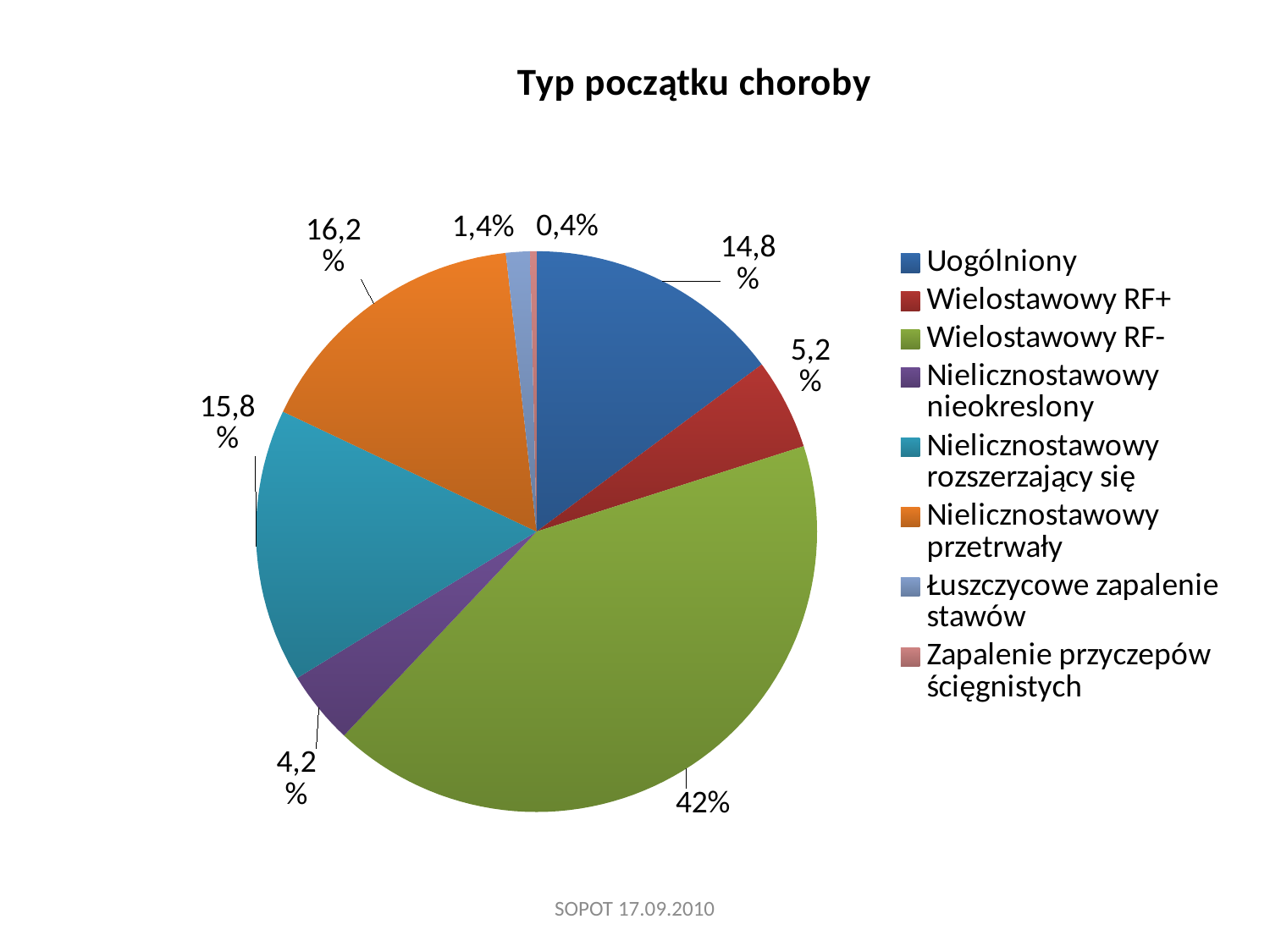
What is the title of the chart? Typ początku choroby How many categories does the legend list? 8 Which is larger, Wielostawowy RF+ or Nielicznostawowy nieokreslony? Wielostawowy RF+ What share of the pie is Wielostawowy RF-? 42% What is the value for Zapalenie przyczepów ścięgnistych? 0,4% What is the value for Uogólniony? 14,8% What is the value for Nielicznostawowy przetrwały? 16,2% Which category has the largest slice? Wielostawowy RF- Which category has the smallest slice? Zapalenie przyczepów ścięgnistych What is the difference between Nielicznostawowy przetrwały and Nielicznostawowy rozszerzający się? 0,4% What colour is the slice for Wielostawowy RF-? green What kind of chart is shown on the slide? pie chart